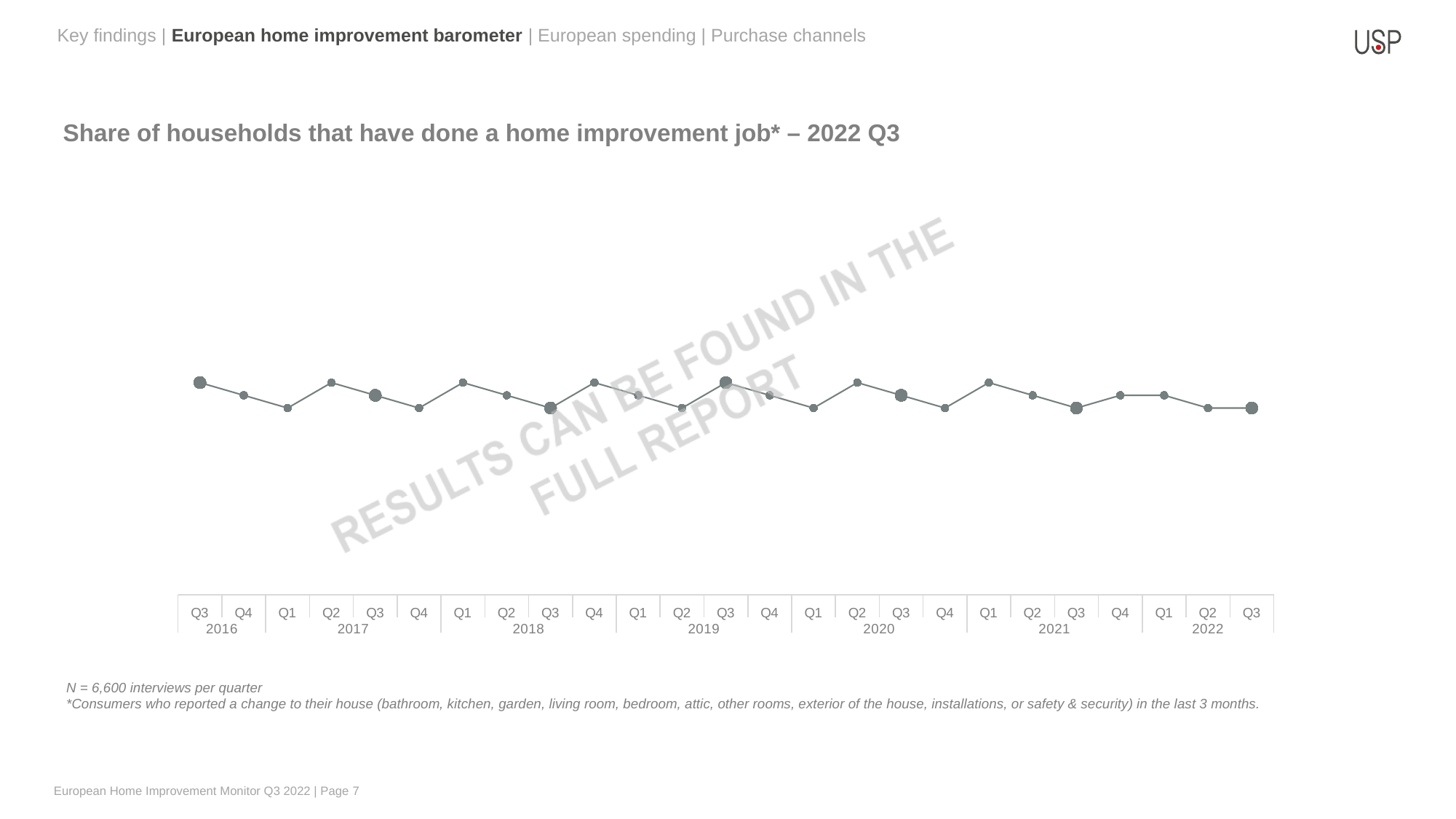
How many quarterly data points are plotted on the chart? 25 Does the line rise or fall from Q1 2017 to Q2 2017? rise Which is higher on the chart, the value for Q1 2021 or the value for Q3 2021? Q1 2021 Which is higher on the chart, the value for Q4 2019 or the value for Q1 2020? Q4 2019 Does the line rise or fall from Q3 2016 to Q1 2017? fall What kind of chart is shown on the slide? line chart Which is higher on the chart, the value for Q2 2017 or the value for Q4 2017? Q2 2017 What is the first quarter shown on the x axis of the chart? Q3 2016 Does the line rise or fall from Q1 2022 to Q3 2022? fall What is the last quarter shown on the x axis of the chart? Q3 2022